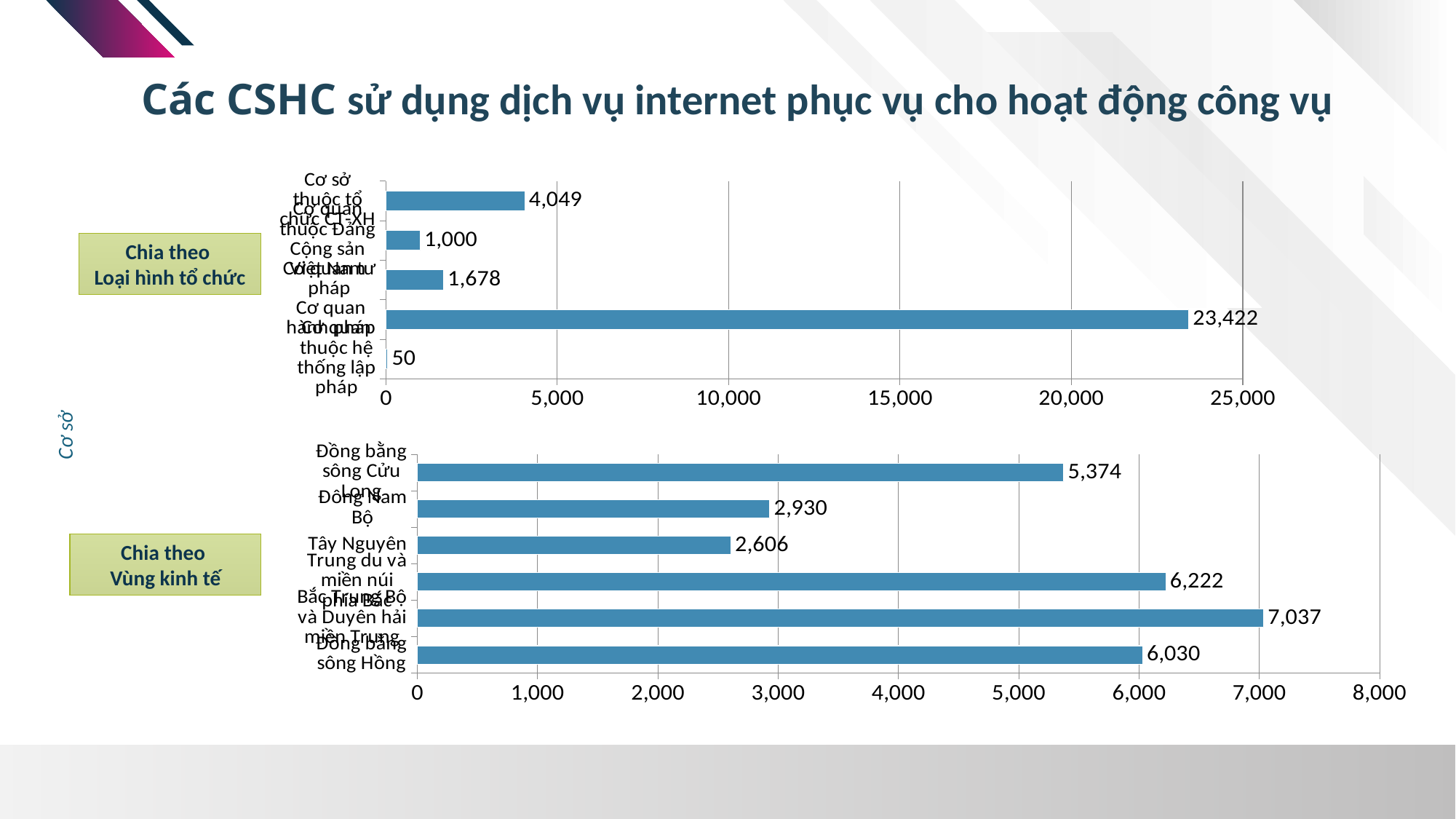
What type of chart is used for the bottom chart (Chia theo Vùng kinh tế)? Bar chart In the bottom chart (Chia theo Vùng kinh tế), which is larger: Đồng bằng sông Cửu Long or Đồng bằng sông Hồng? Đồng bằng sông Hồng In the bottom chart (Chia theo Vùng kinh tế), what is the value for Tây Nguyên? 2,606 In the bottom chart (Chia theo Vùng kinh tế), what is the value for Đồng bằng sông Hồng? 6,030 In the top chart (Chia theo Loại hình tổ chức), which category has the highest value? Cơ quan hành pháp In the bottom chart (Chia theo Vùng kinh tế), which region has the highest value? Bắc Trung Bộ và Duyên hải miền Trung In the top chart (Chia theo Loại hình tổ chức), what is the value for Cơ quan hành pháp? 23,422 In the top chart (Chia theo Loại hình tổ chức), how many categories are plotted? 5 In the top chart (Chia theo Loại hình tổ chức), what is the value for Cơ quan tư pháp? 1,678 In the top chart (Chia theo Loại hình tổ chức), which category has the lowest value? Cơ quan thuộc hệ thống lập pháp In the bottom chart (Chia theo Vùng kinh tế), what is the difference between Trung du và miền núi phía Bắc and Đông Nam Bộ? 3,292 In the bottom chart (Chia theo Vùng kinh tế), how many regions are plotted? 6